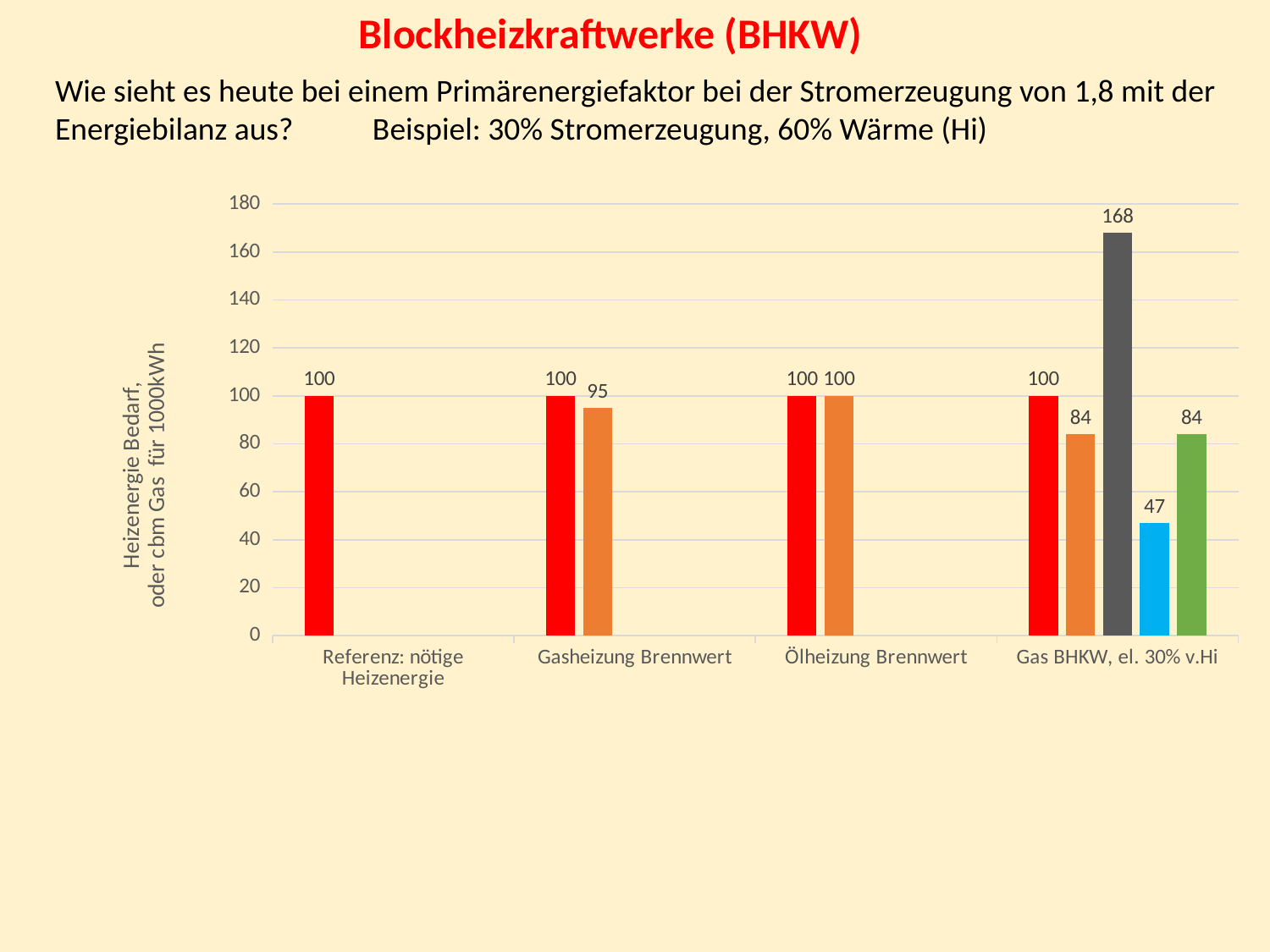
What is the difference between the dark grey bar (168) and the orange bar (84) for "Gas BHKW, el. 30% v.Hi"? 84 What is the value of the orange bar for "Ölheizung Brennwert"? 100 What is the label of the vertical axis of the chart? Heizenergie Bedarf, oder cbm Gas für 1000kWh Which is larger for "Gasheizung Brennwert": the red bar or the orange bar? the red bar How many categories are shown on the x axis of the chart? 4 What is the value of the green bar for "Gas BHKW, el. 30% v.Hi"? 84 What kind of chart is shown on the slide? bar chart What is the value of the dark grey bar for "Gas BHKW, el. 30% v.Hi"? 168 What is the value of the red bar for "Referenz: nötige Heizenergie"? 100 What is the value of the orange bar for "Gasheizung Brennwert"? 95 What is the value of the blue bar for "Gas BHKW, el. 30% v.Hi"? 47 Which category contains the highest bar in the chart? Gas BHKW, el. 30% v.Hi